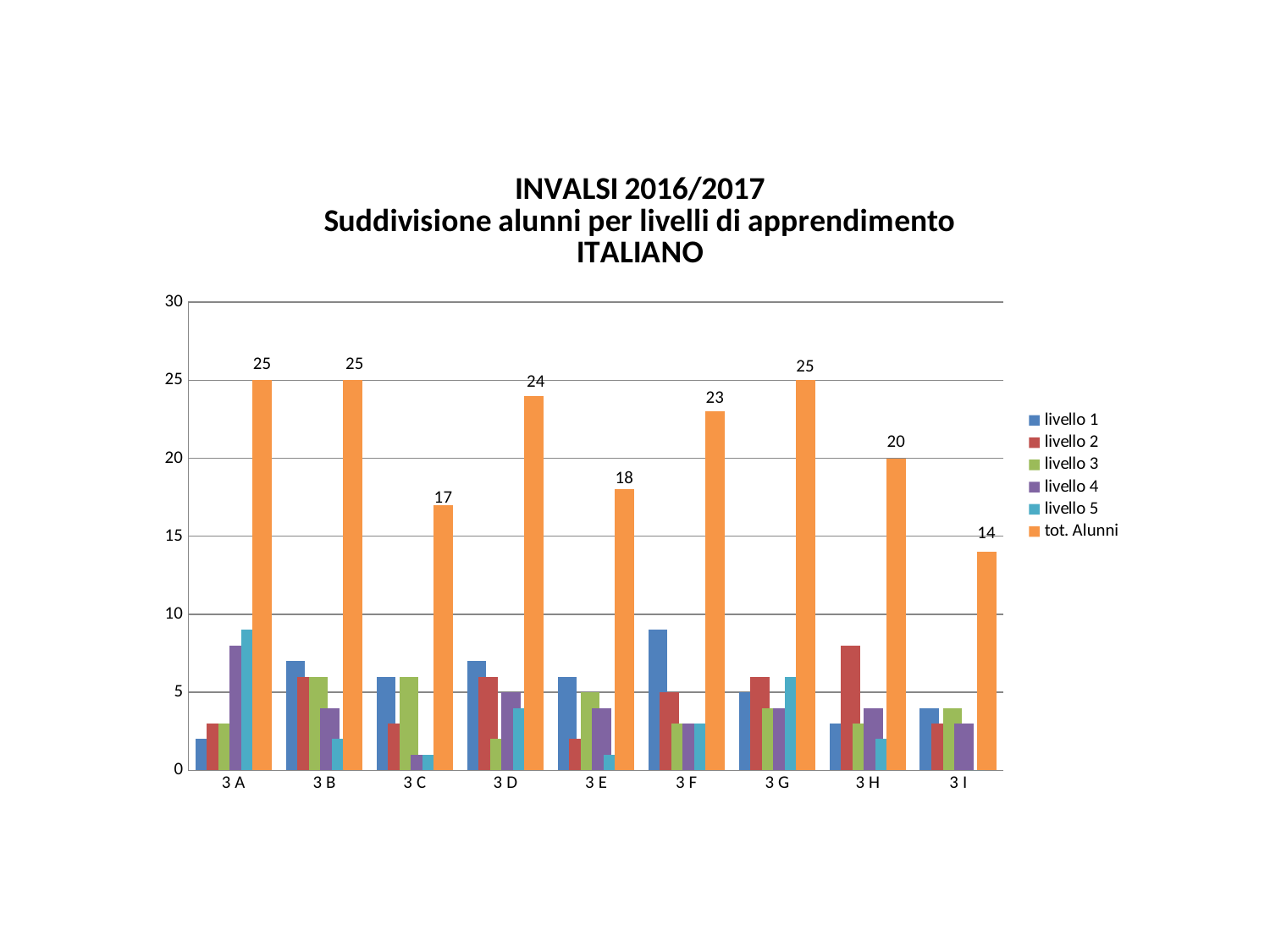
What is the value of tot. Alunni for class 3 C? 17 Is the livello 1 value for class 3 F greater or less than 5? greater How many series does the legend list? 6 What is the difference between the tot. Alunni values for 3 F and 3 I? 9 Which class has the lowest tot. Alunni value? 3 I What is the value of tot. Alunni for class 3 H? 20 Which class has a larger tot. Alunni value, 3 F or 3 H? 3 F What is the difference between the tot. Alunni values for 3 D and 3 C? 7 Is the livello 5 value for class 3 C greater or less than 5? less What kind of chart is shown on the slide? Bar chart How many classes are shown on the x axis? 9 What is the value of tot. Alunni for class 3 D? 24